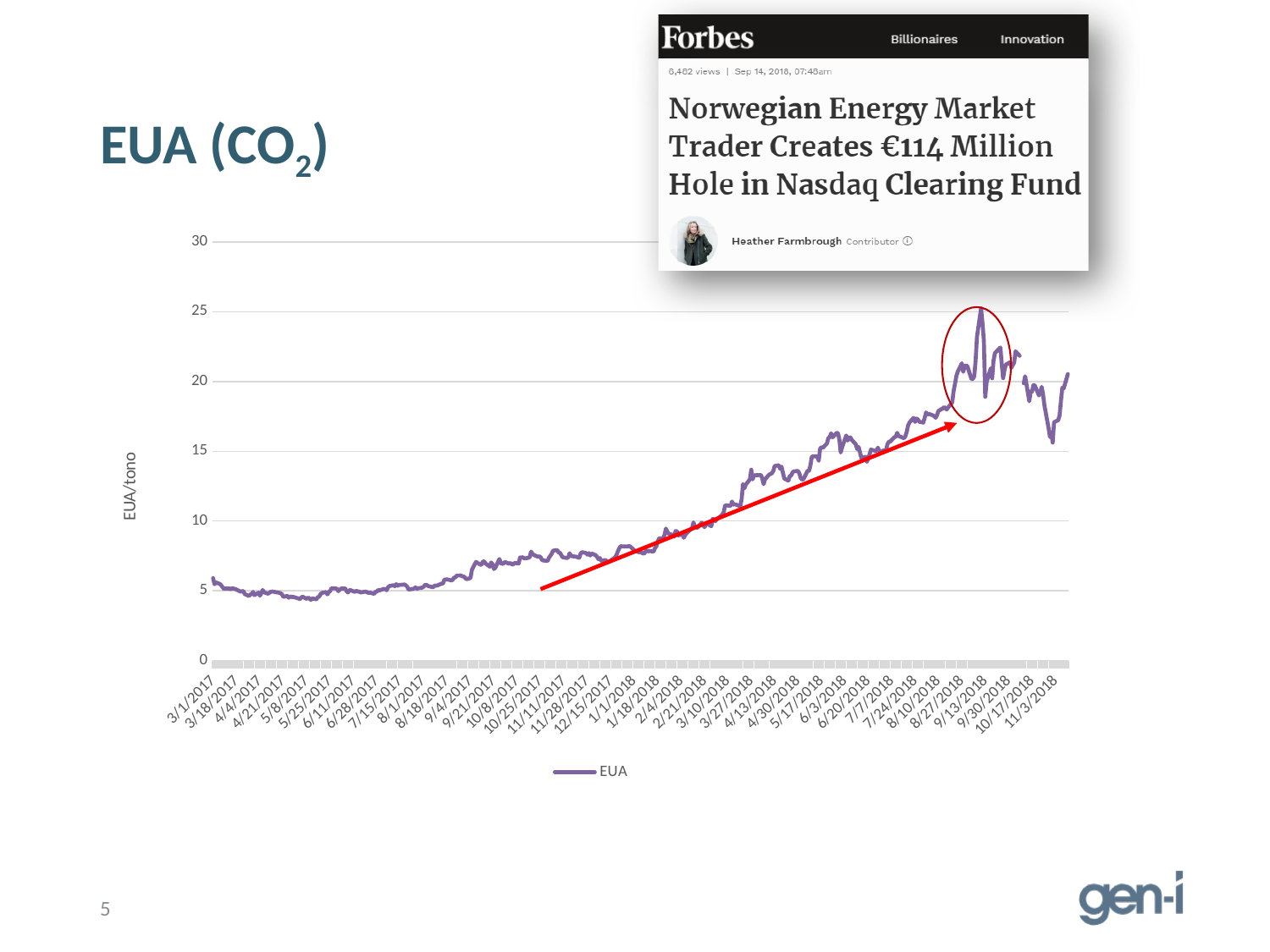
What is the label on the vertical axis of the chart? EUA/tono Is the EUA value on 6/3/2018 greater or less than 10? greater Is the EUA value on 11/3/2018 greater or less than 15? greater Around which date does the EUA series reach its highest value? 9/13/2018 Overall, does the EUA value rise or fall from 3/1/2017 to 11/3/2018? rise What is the name of the series shown in the chart legend? EUA Is the EUA value on 9/13/2018 larger or smaller than the value on 3/1/2017? larger What kind of chart is shown on the slide? line chart How many series does the chart legend list? 1 Is the EUA value on 1/1/2018 greater or less than 10? less